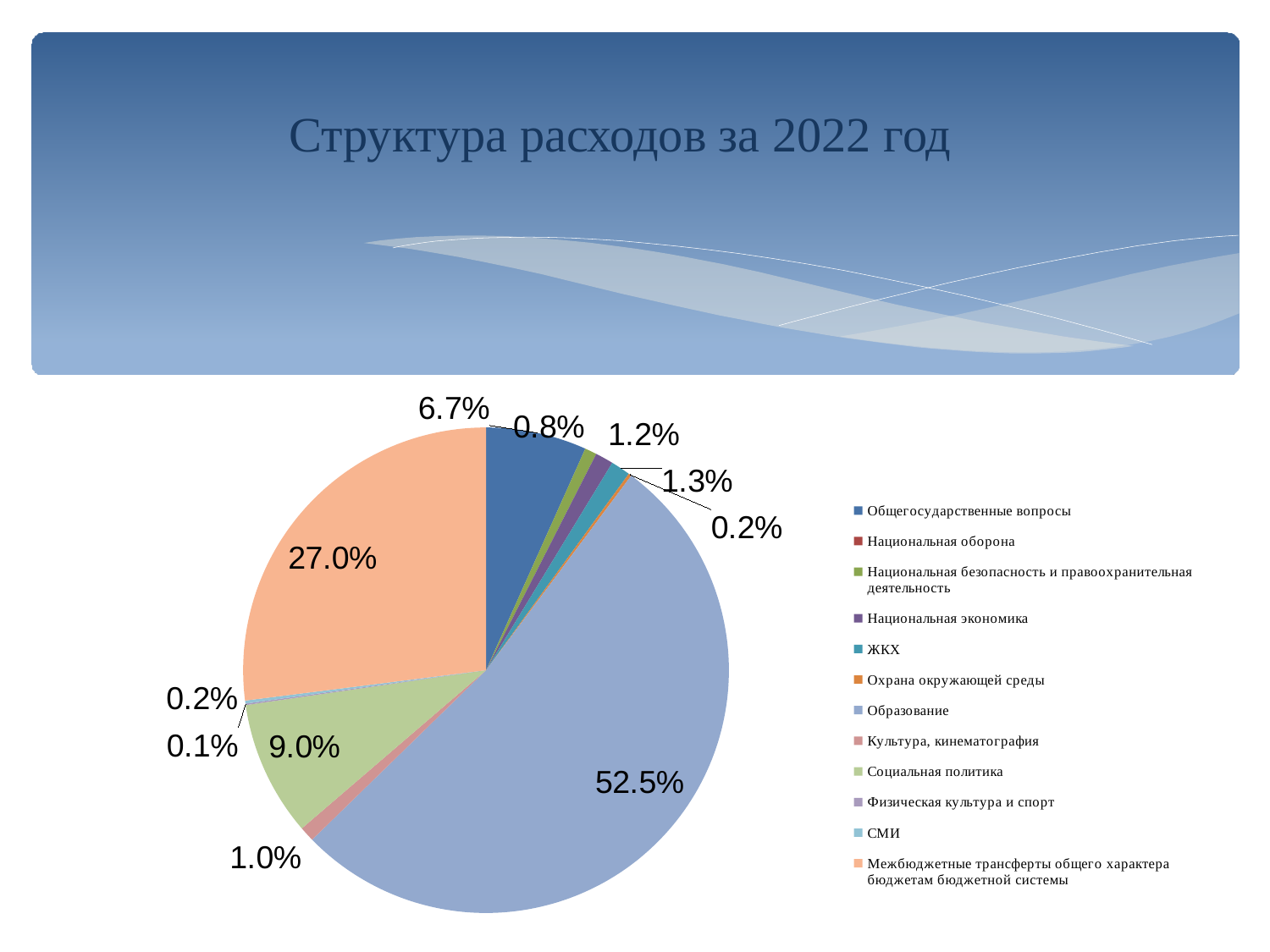
Is the share for Образование greater or less than 50%? greater How many categories does the legend list? 12 What share is shown for Социальная политика? 9.0% Which is larger: the share for Социальная политика or for Общегосударственные вопросы? Социальная политика What share is shown for Общегосударственные вопросы? 6.7% What is the difference in percentage points between the Образование share and the Межбюджетные трансферты share? 25.5 What share of expenditures is Образование? 52.5% What share is shown for Культура, кинематография? 1.0% What is the title of the chart? Структура расходов за 2022 год Which category has the largest share of expenditures? Образование What type of chart is shown on the slide? pie chart What share is shown for Межбюджетные трансферты общего характера бюджетам бюджетной системы? 27.0%